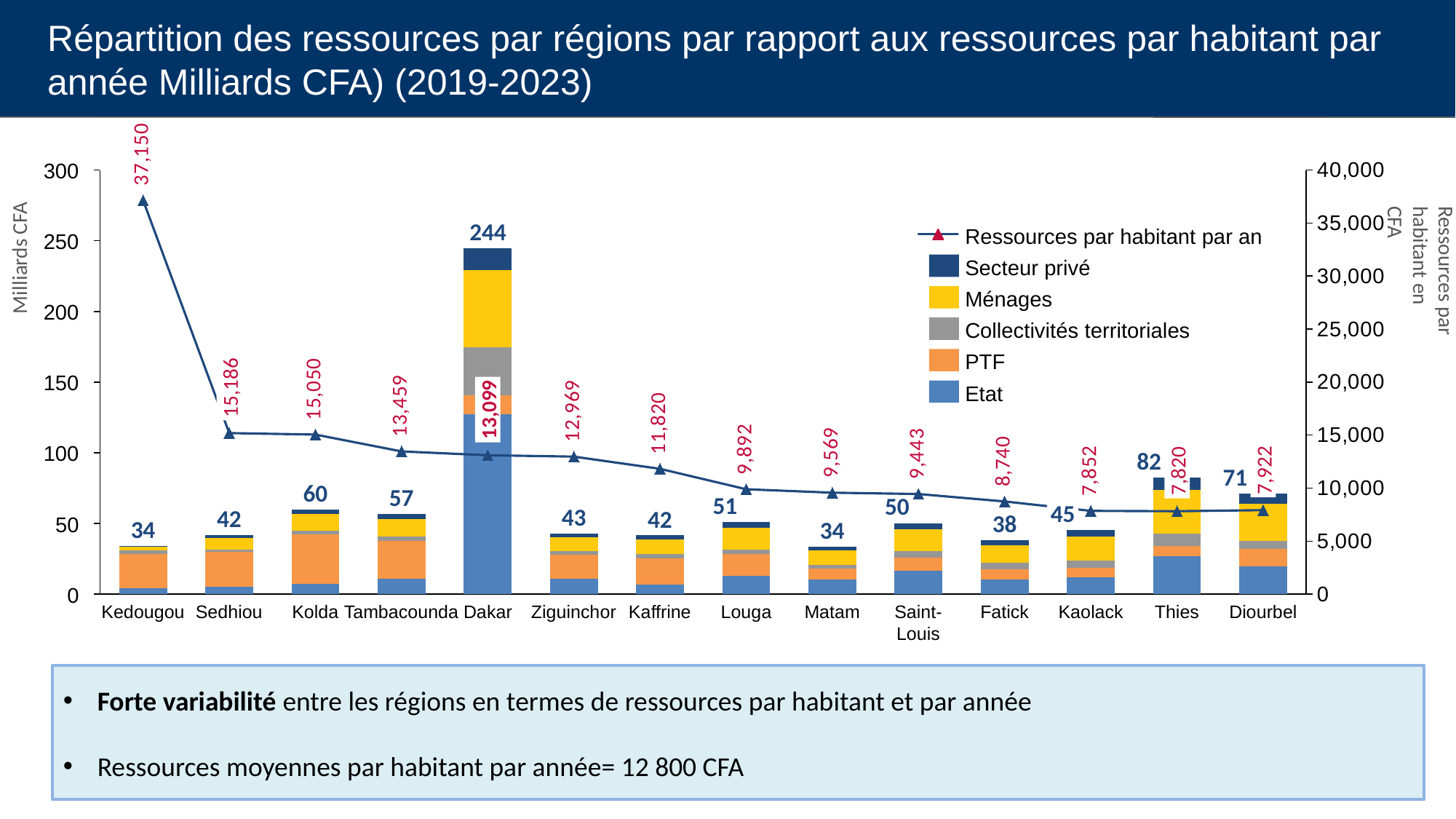
Does the 'Ressources par habitant par an' line generally rise or fall from Kedougou to Diourbel? fall Is the Etat segment for Dakar greater or less than 100 Milliards CFA? greater What is the difference between the total resources of Thies and Diourbel? 11 Which region has the highest total resources bar? Dakar Which region has the lowest value of 'Ressources par habitant par an'? Thies What is the value of 'Ressources par habitant par an' for Kedougou? 37,150 What is the difference between the 'Ressources par habitant par an' values of Kedougou and Sedhiou? 21,964 What is the total resources value (Milliards CFA) shown for Dakar? 244 How many series does the legend list? 6 Which has a larger total resources bar, Kolda or Tambacounda? Kolda How many regions are shown on the x axis? 14 What is the value of 'Ressources par habitant par an' for Fatick? 8,740